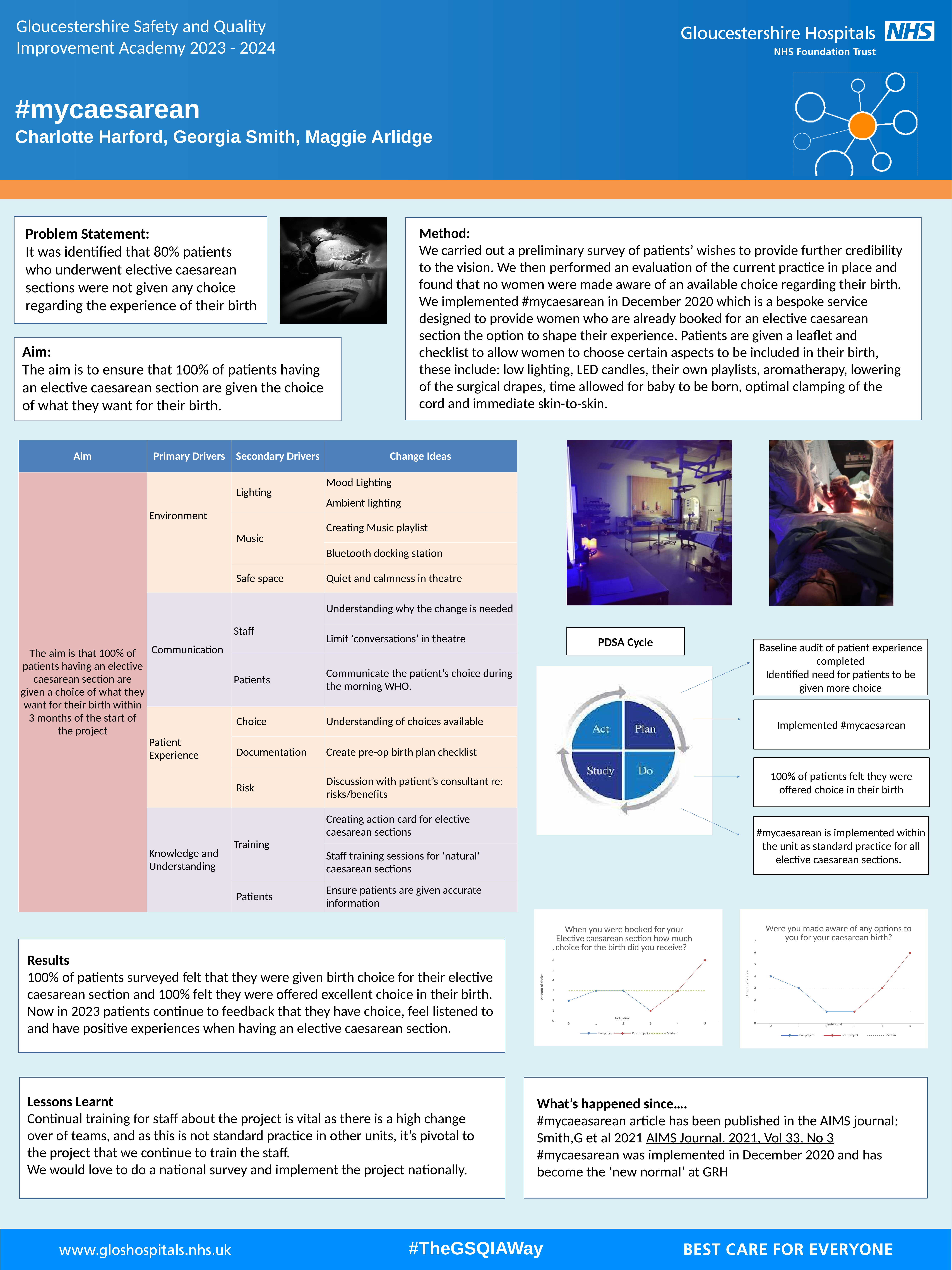
On the chart titled "Were you made aware of any options to you for your caesarean birth?", what is the y-axis label? Amount of choice On the chart titled "When you were booked for your Elective caesarean section how much choice for the birth did you receive?", is the Post-project value for individual 5 greater or less than 4? greater What kind of chart is the chart titled "When you were booked for your Elective caesarean section how much choice for the birth did you receive?"? line chart On the chart titled "Were you made aware of any options to you for your caesarean birth?", does the Pre-project series rise or fall from individual 0 to individual 2? fall How many series does the legend list on the chart titled "When you were booked for your Elective caesarean section how much choice for the birth did you receive?"? 3 How many series does the legend list on the chart titled "Were you made aware of any options to you for your caesarean birth?"? 3 On the chart titled "When you were booked for your Elective caesarean section how much choice for the birth did you receive?", what are the three legend entries? Pre-project, Post project, Median On the chart titled "Were you made aware of any options to you for your caesarean birth?", is the Post-project value for individual 5 greater or less than 5? greater On the chart titled "When you were booked for your Elective caesarean section how much choice for the birth did you receive?", does the Post-project series rise or fall from individual 3 to individual 5? rise What kind of chart is the chart titled "Were you made aware of any options to you for your caesarean birth?"? line chart On the chart titled "When you were booked for your Elective caesarean section how much choice for the birth did you receive?", which is larger: the Post-project value for individual 5 or the Pre-project value for individual 0? Post-project value for individual 5 On the chart titled "Were you made aware of any options to you for your caesarean birth?", is the Pre-project value for individual 2 greater or less than 3? less